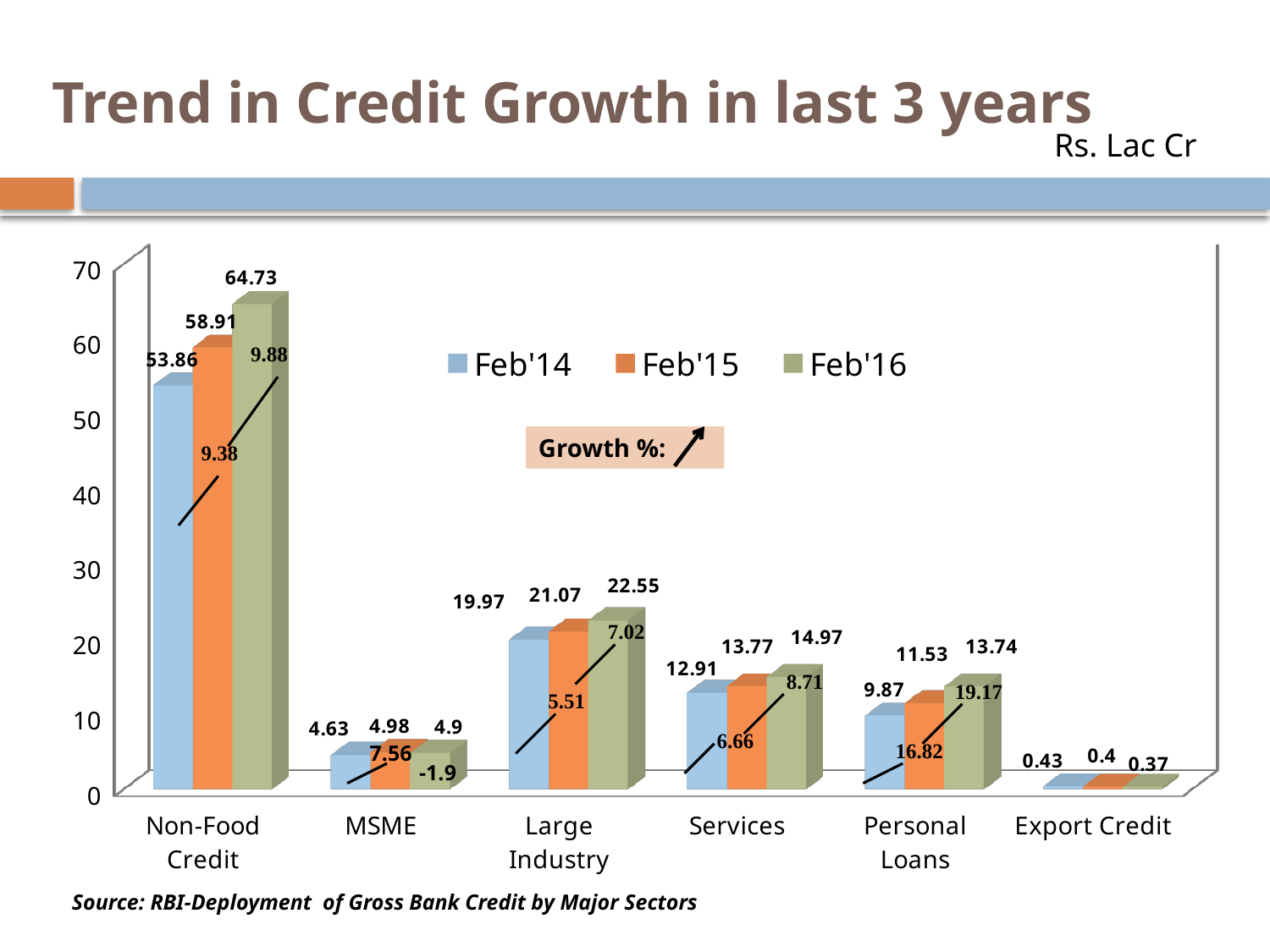
Which category has the highest Feb'16 value? Non-Food Credit What is the Feb'15 value for Personal Loans? 11.53 Is the Feb'15 value for Large Industry greater or less than 20? greater Which is larger: the Feb'16 value for Services or the Feb'16 value for Personal Loans? Services What is the difference between the Feb'16 and Feb'14 values for Non-Food Credit? 10.87 What is the Feb'14 value for Large Industry? 19.97 Do the values for Export Credit rise or fall from Feb'14 to Feb'16? Fall How many series does the legend list? 3 What is the Feb'16 value for Non-Food Credit? 64.73 What kind of chart is shown on the slide? Bar chart Which category has the lowest Feb'14 value? Export Credit How many categories are shown on the x axis? 6